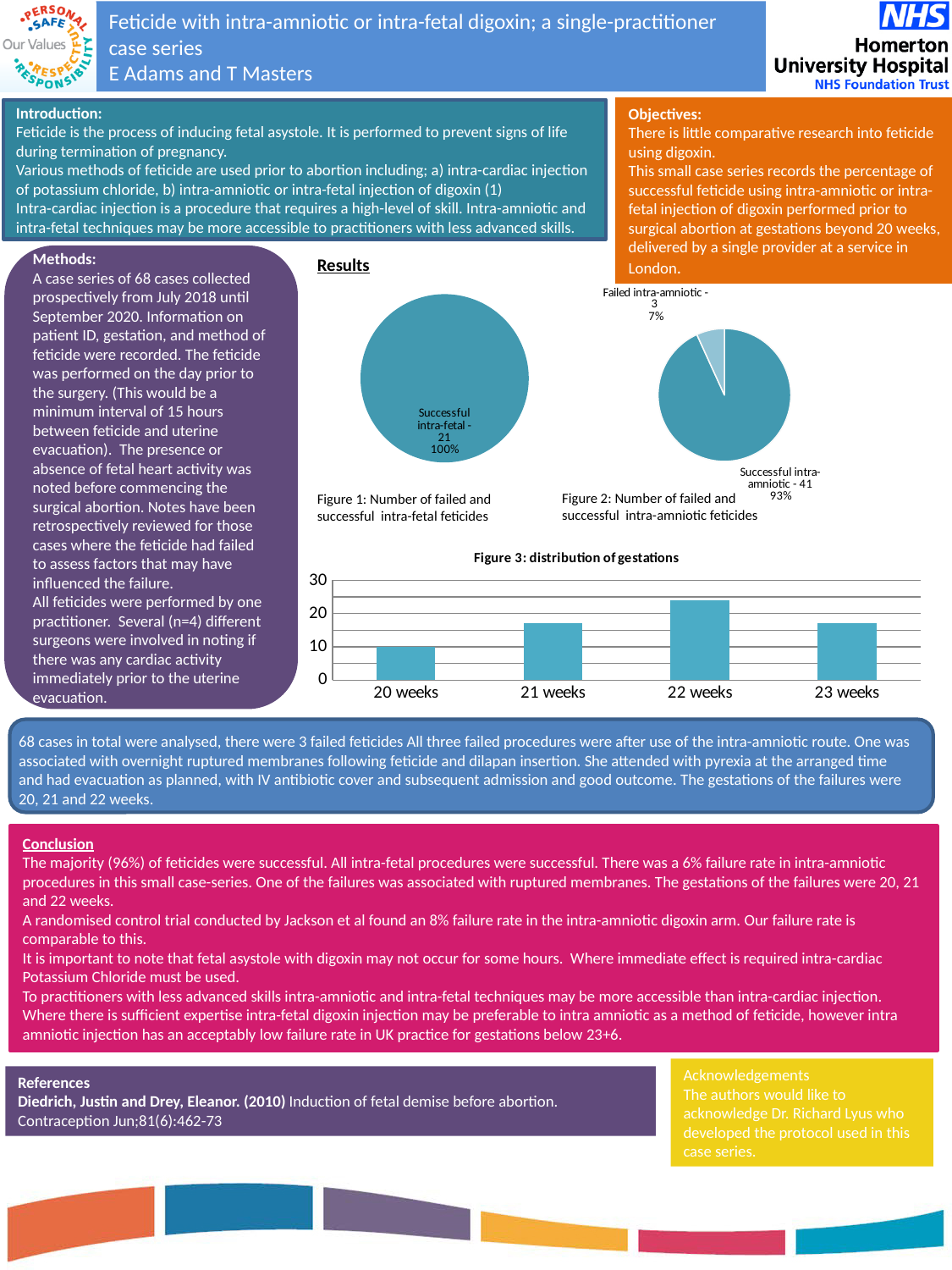
In Figure 2, how many successful intra-amniotic feticides are shown? 41 In Figure 1, how many successful intra-fetal feticides are shown? 21 In Figure 3, which has the larger value, 22 weeks or 20 weeks? 22 weeks In Figure 1, what percentage of the pie does the successful intra-fetal slice represent? 100% In Figure 3, which gestation category has the lowest bar? 20 weeks In Figure 2, how many failed intra-amniotic feticides are shown? 3 What type of chart is Figure 3: distribution of gestations? Bar chart In Figure 3, is the value for 22 weeks greater or less than 20? greater In Figure 2, what percentage share of the pie is the successful intra-amniotic slice? 93% In Figure 2, what percentage share of the pie is the failed intra-amniotic slice? 7% In Figure 3, which gestation category has the highest bar? 22 weeks In Figure 3, how many gestation categories are shown on the x axis? 4